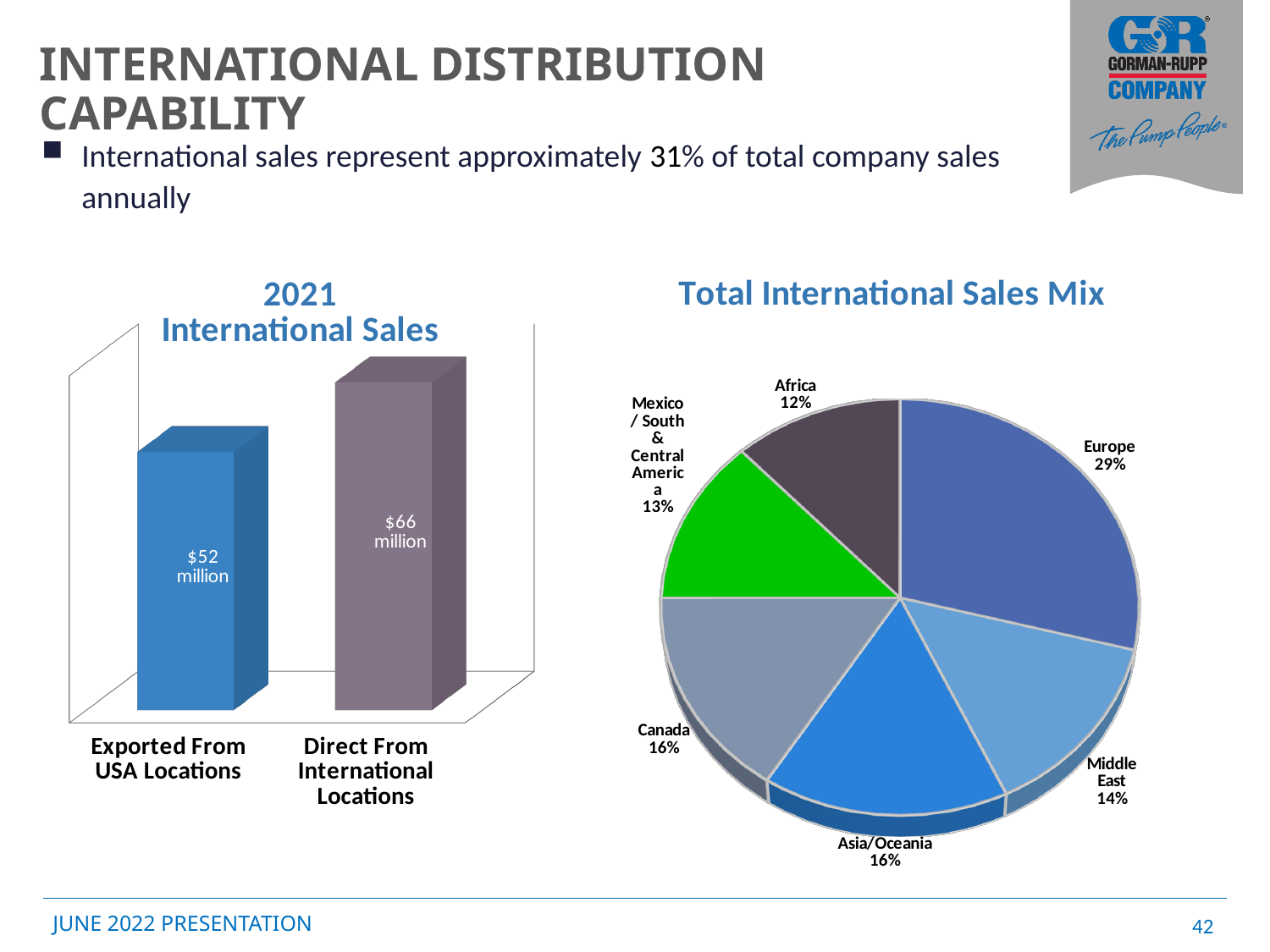
In the '2021 International Sales' chart, what is the difference between Direct From International Locations and Exported From USA Locations? $14 million What kind of chart is the 'Total International Sales Mix' chart? Pie chart In the 'Total International Sales Mix' chart, which region has the smallest share? Africa What kind of chart is the '2021 International Sales' chart? Bar chart In the '2021 International Sales' chart, what is the value for Exported From USA Locations? $52 million In the 'Total International Sales Mix' chart, which region has the largest share? Europe In the 'Total International Sales Mix' chart, how many slices are there? 6 In the 'Total International Sales Mix' chart, what share does Mexico / South & Central America have? 13% In the '2021 International Sales' chart, what is the value for Direct From International Locations? $66 million In the '2021 International Sales' chart, which category has the higher value? Direct From International Locations In the 'Total International Sales Mix' chart, what share does Europe have? 29% In the '2021 International Sales' chart, how many categories are shown? 2